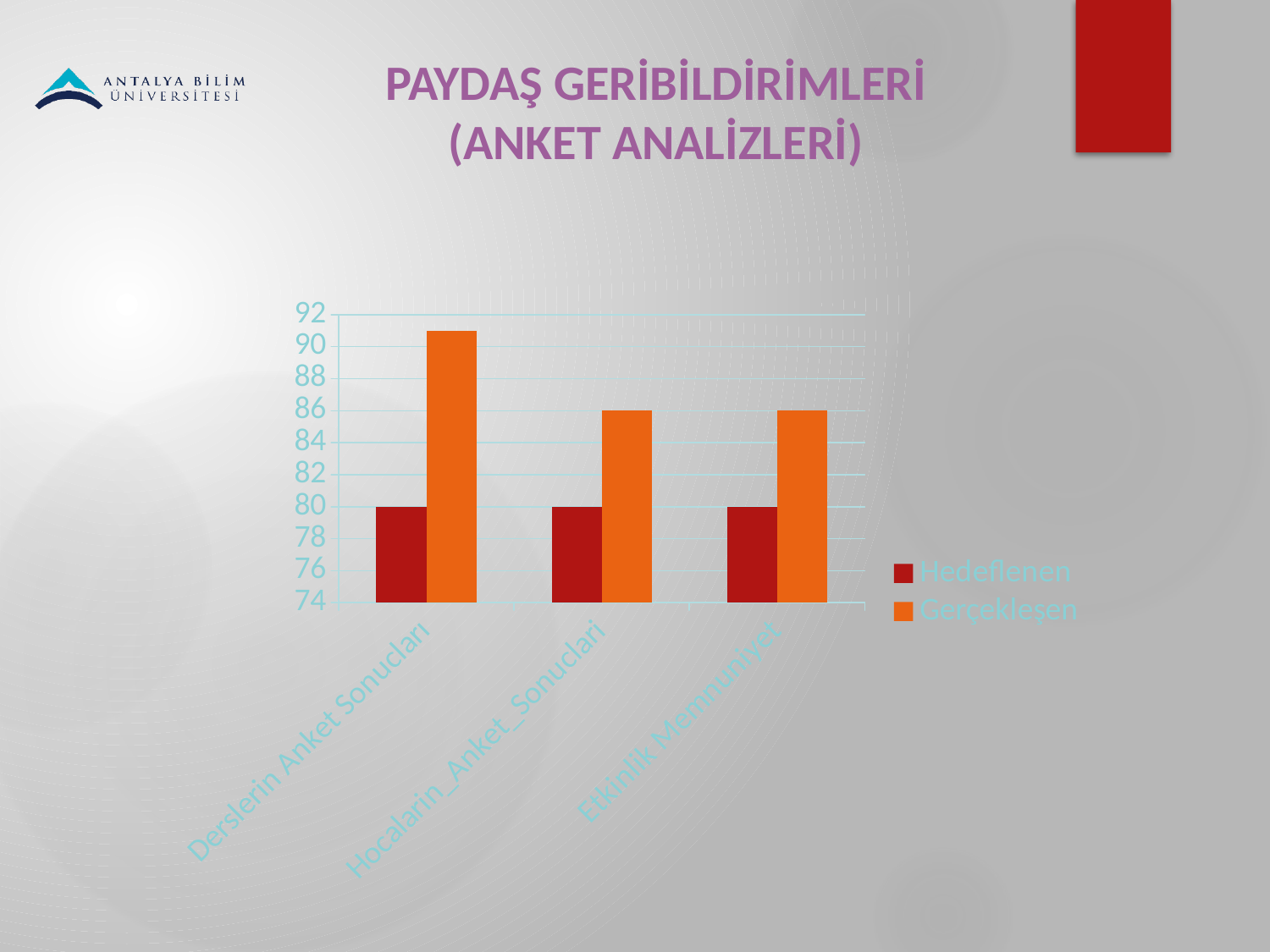
Which category has the highest Gerçekleşen value? Derslerin Anket Sonucları For Etkinlik Memnuniyet, what is the difference between the Gerçekleşen and Hedeflenen values? 6 What is the Hedeflenen value for Derslerin Anket Sonucları? 80 What is the Gerçekleşen value for Hocalarin_Anket_Sonuclari? 86 What kind of chart is shown on the slide? bar chart For Hocalarin_Anket_Sonuclari, which is larger: Hedeflenen or Gerçekleşen? Gerçekleşen What is the Gerçekleşen value for Etkinlik Memnuniyet? 86 What is the Hedeflenen value for Etkinlik Memnuniyet? 80 How many categories are shown on the x axis? 3 Is the Gerçekleşen value for Derslerin Anket Sonucları greater or less than 90? greater What colour represents the Hedeflenen series in the legend? dark red How many series does the legend list? 2